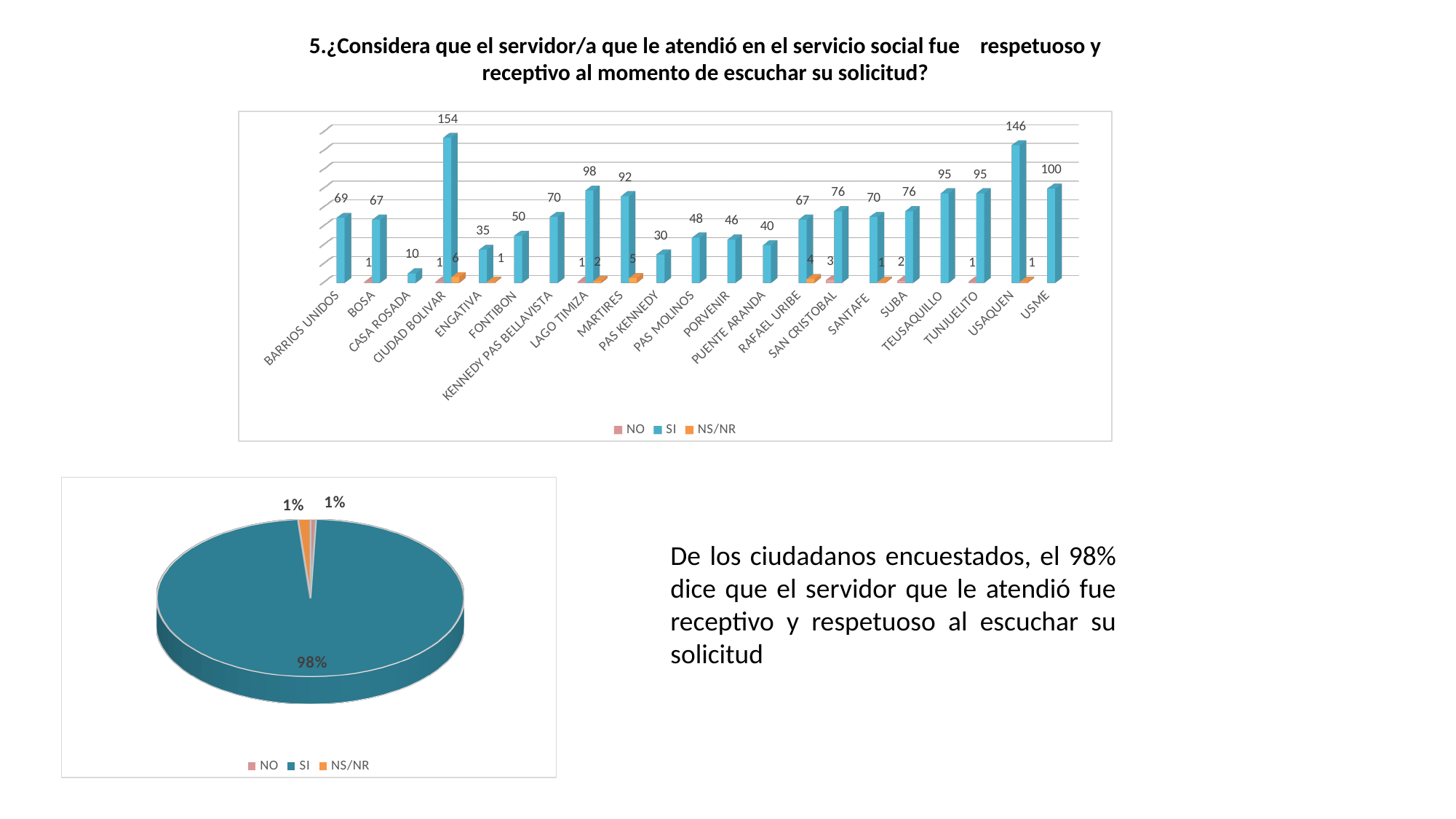
In the top bar chart, which has the larger SI value, LAGO TIMIZA or MARTIRES? LAGO TIMIZA What kind of chart is the top chart on the slide? bar chart What kind of chart is the bottom-left chart on the slide? pie chart In the top bar chart, which category has the lowest SI value? CASA ROSADA In the top bar chart, what is the difference between the SI values for USAQUEN and USME? 46 In the bottom-left pie chart, what share does the SI slice represent? 98% How many categories are shown on the x axis of the top bar chart? 21 How many series does the legend of the top bar chart list? 3 In the top bar chart, what is the NS/NR value for CIUDAD BOLIVAR? 6 In the top bar chart, what is the SI value for CIUDAD BOLIVAR? 154 In the top bar chart, what is the SI value for USME? 100 In the top bar chart, which category has the highest SI value? CIUDAD BOLIVAR